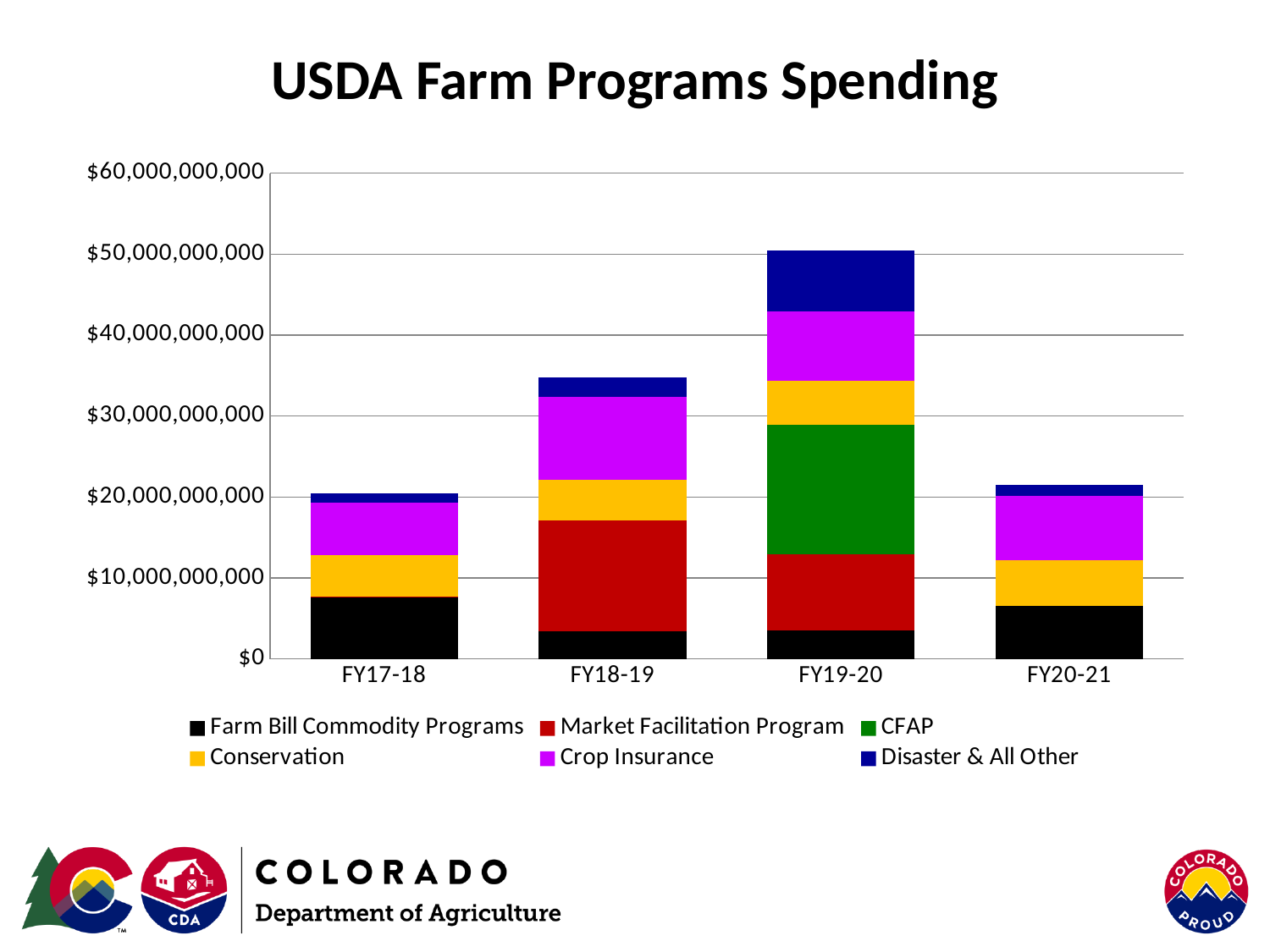
Is the total spending for FY17-18 greater or less than $30,000,000,000? less What is the title of the chart? USDA Farm Programs Spending Which has the larger total spending, FY18-19 or FY20-21? FY18-19 Which fiscal year has the highest total spending? FY19-20 Is the total spending for FY19-20 greater or less than $40,000,000,000? greater Is the total spending for FY18-19 greater or less than $30,000,000,000? greater Which series is shown in green in the legend? CFAP Does total spending rise or fall from FY17-18 to FY19-20? rise What kind of chart is shown on the slide? Stacked bar chart How many fiscal years are shown on the x axis? 4 How many series does the legend list? 6